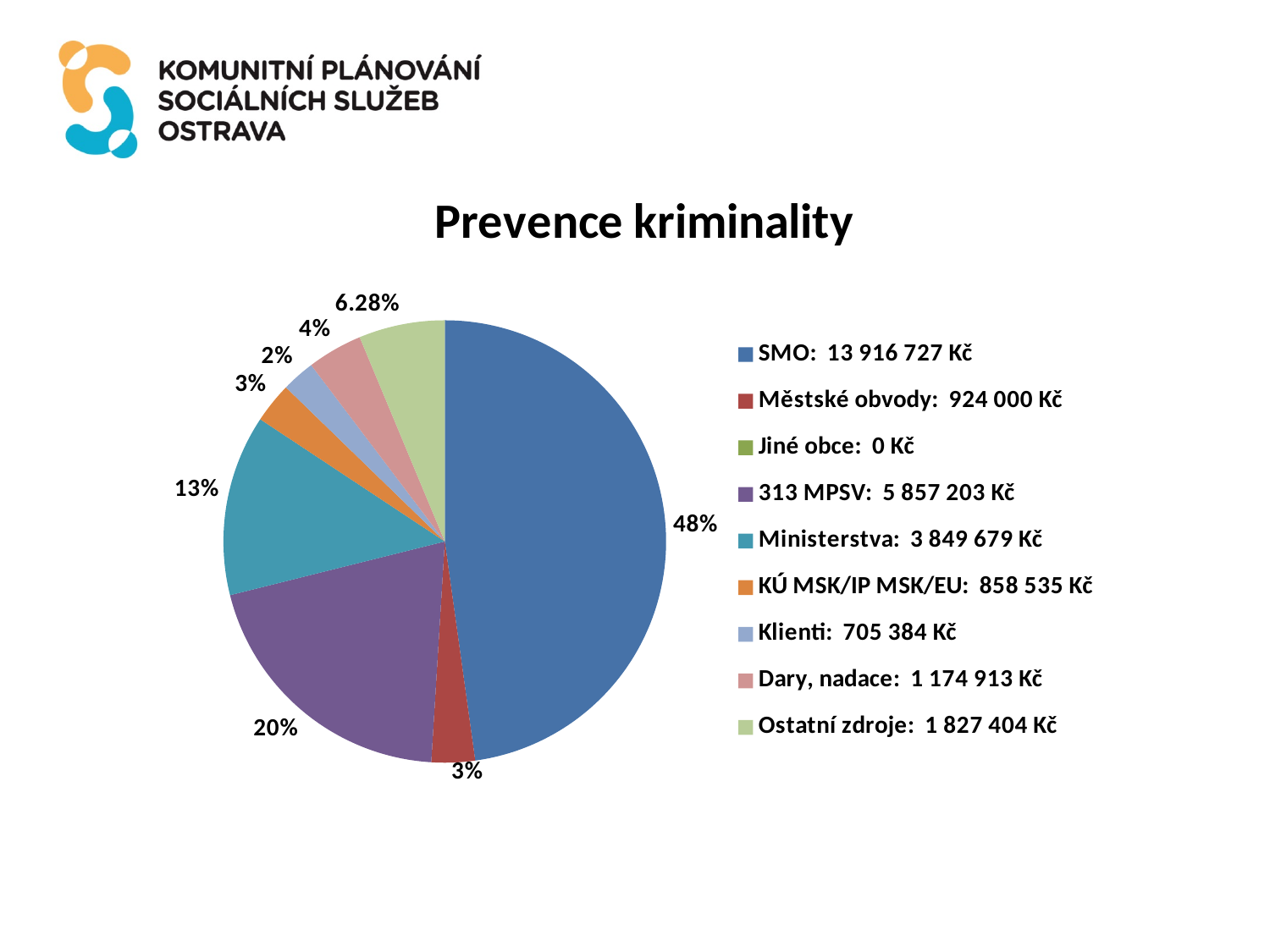
What amount is shown for Ostatní zdroje in the legend? 1 827 404 Kč How many entries does the legend list? 9 Which category has the largest slice of the pie? SMO What share of the pie does SMO represent? 48% What kind of chart is shown on the slide? pie chart Which is larger, the amount for Klienti or the amount for Dary, nadace? Dary, nadace What share of the pie does Ministerstva represent? 13% What amount is shown for 313 MPSV in the legend? 5 857 203 Kč What amount is shown for SMO in the legend? 13 916 727 Kč What share of the pie does Ostatní zdroje represent? 6.28% Which category has the smallest amount in the legend? Jiné obce What is the title of the chart? Prevence kriminality